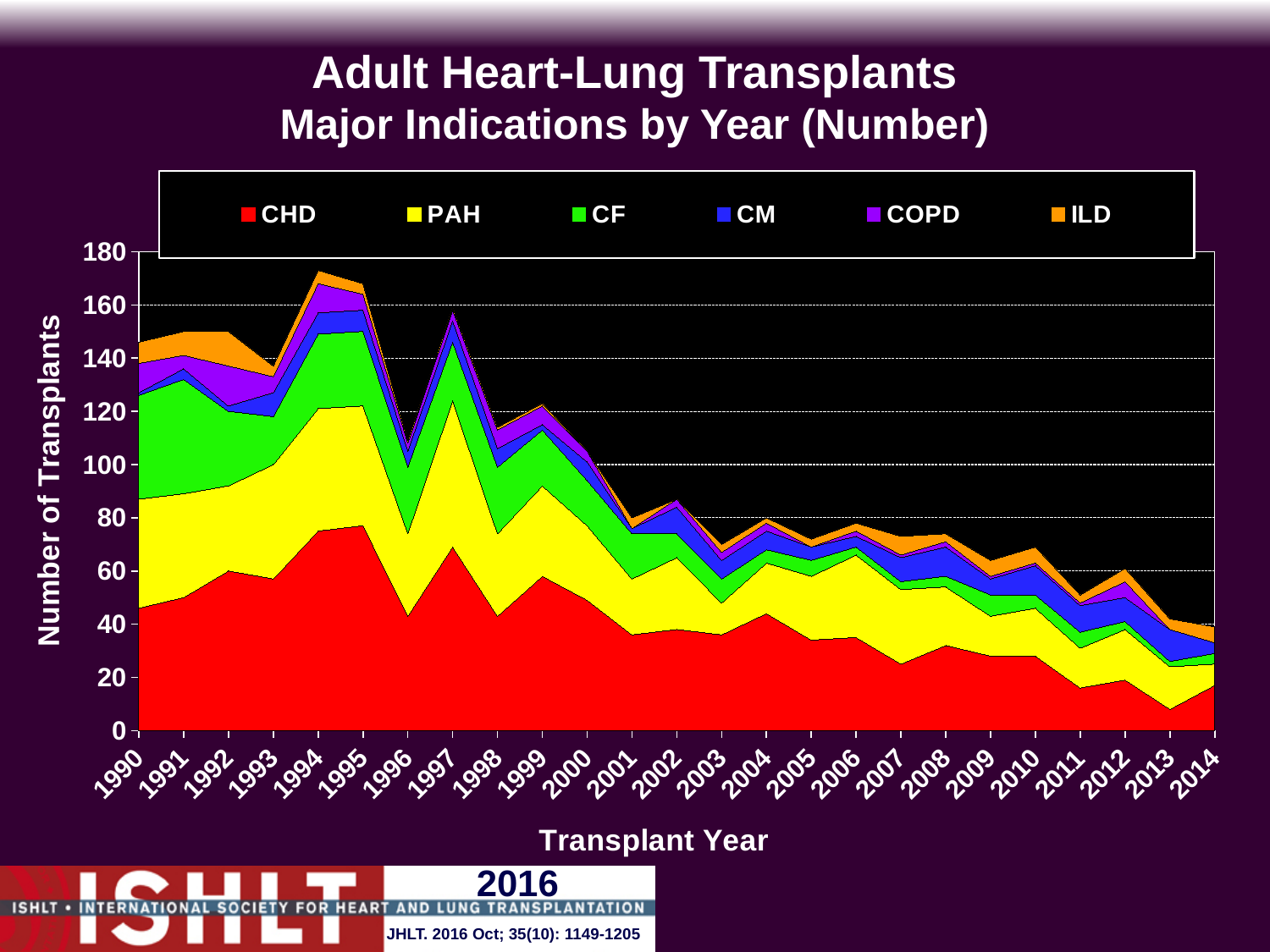
How many series does the legend list? 6 Which year has the larger total number of transplants, 1990 or 2014? 1990 What kind of chart is shown on the slide? Stacked area chart Is the total number of transplants in 1994 greater or less than 160? greater Is the total number of transplants in 2001 greater or less than 100? less Overall, do total adult heart-lung transplants rise or fall from 1990 to 2014? fall Is the total number of transplants in 2010 greater or less than 80? less How many transplant years are shown along the x axis? 25 Which indication is shown in red in the legend? CHD What is the label of the y axis? Number of Transplants